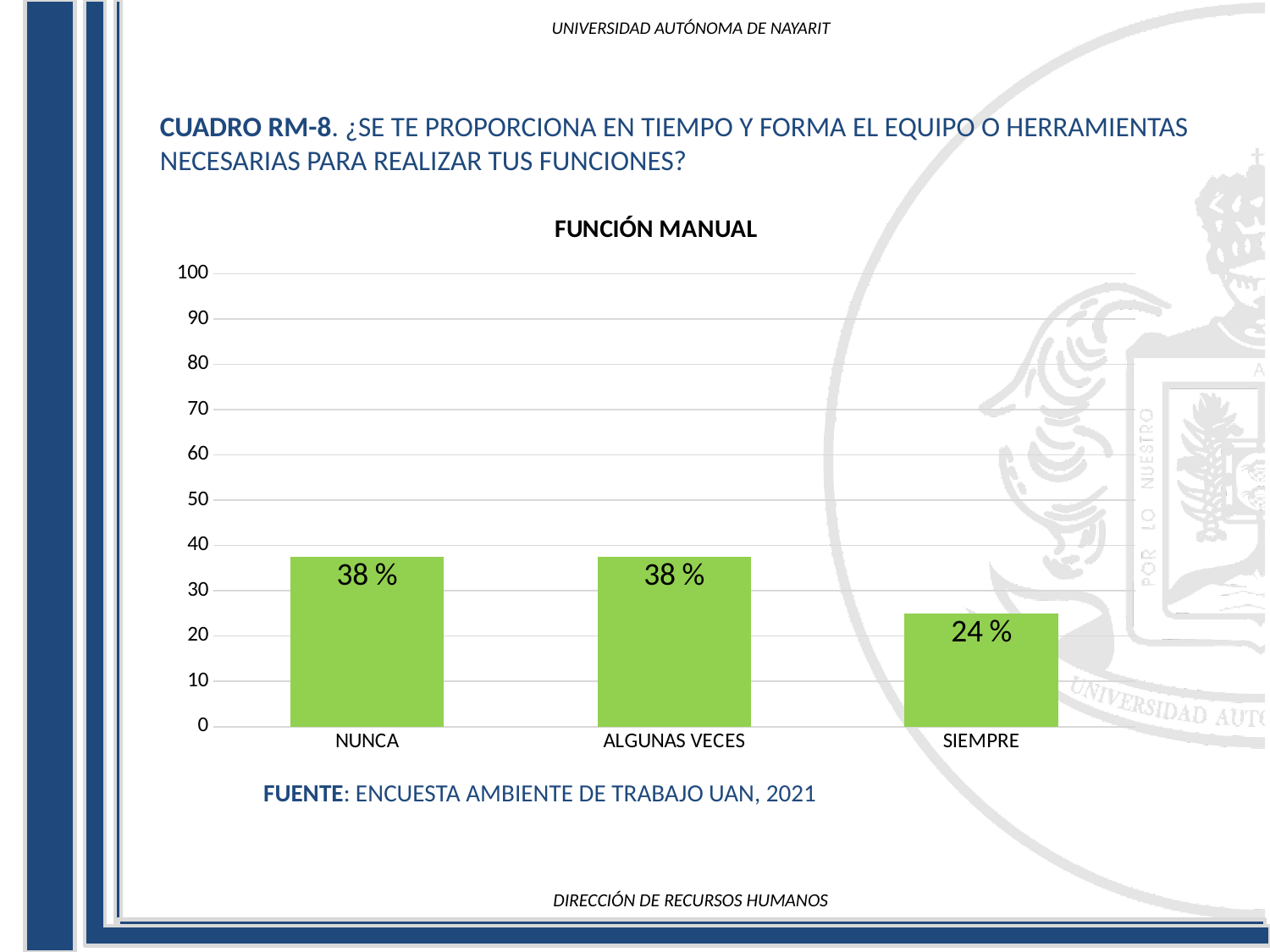
What is the value for NUNCA in the FUNCIÓN MANUAL chart? 38 % Which is larger in the FUNCIÓN MANUAL chart, the value for NUNCA or the value for SIEMPRE? NUNCA What colour are the bars in the FUNCIÓN MANUAL chart? green What is the value for ALGUNAS VECES in the FUNCIÓN MANUAL chart? 38 % How many categories are shown on the x axis of the FUNCIÓN MANUAL chart? 3 What is the value for SIEMPRE in the FUNCIÓN MANUAL chart? 24 % What kind of chart is the FUNCIÓN MANUAL chart? bar chart Is the value for SIEMPRE greater or less than 30 in the FUNCIÓN MANUAL chart? less What is the title of the chart on the slide? FUNCIÓN MANUAL Is the value for NUNCA greater or less than 30 in the FUNCIÓN MANUAL chart? greater What is the difference between the values for ALGUNAS VECES and SIEMPRE in the FUNCIÓN MANUAL chart? 14 % Which category has the lowest value in the FUNCIÓN MANUAL chart? SIEMPRE